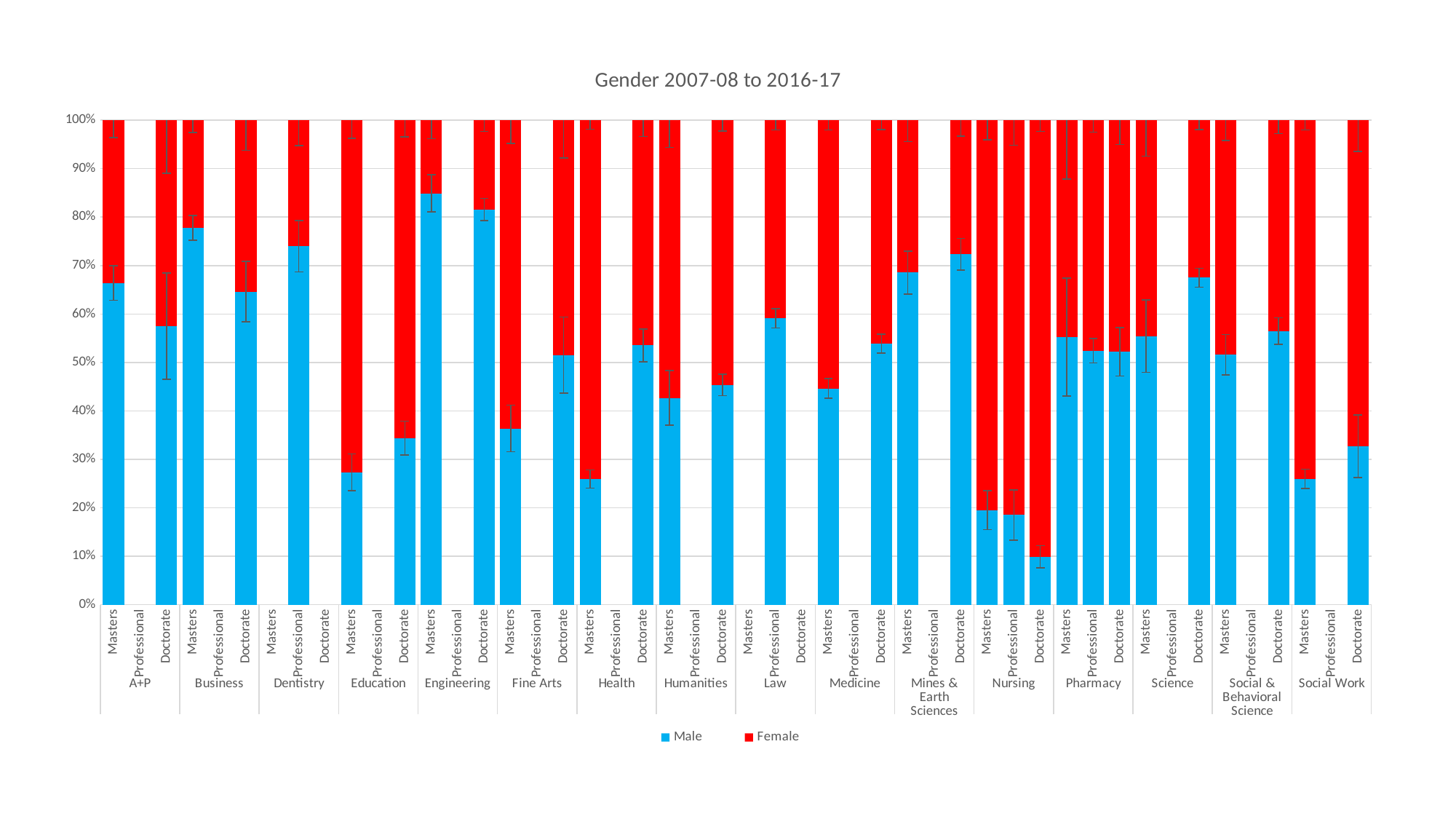
What is the title of the chart? Gender 2007-08 to 2016-17 How many disciplines are listed along the x axis? 16 Which has the larger Male share, Business Masters or Education Masters? Business Masters Which bar has the lowest Male share? Nursing Doctorate What are the two series named in the legend? Male and Female What kind of chart is shown on the slide? Stacked bar chart Is the Male share for Engineering Masters greater or less than 80%? greater Is the Male share for Dentistry Professional greater or less than 70%? greater Is the Male share for Nursing Doctorate greater or less than 20%? less Which bar has the highest Male share? Engineering Masters How many series does the legend list? 2